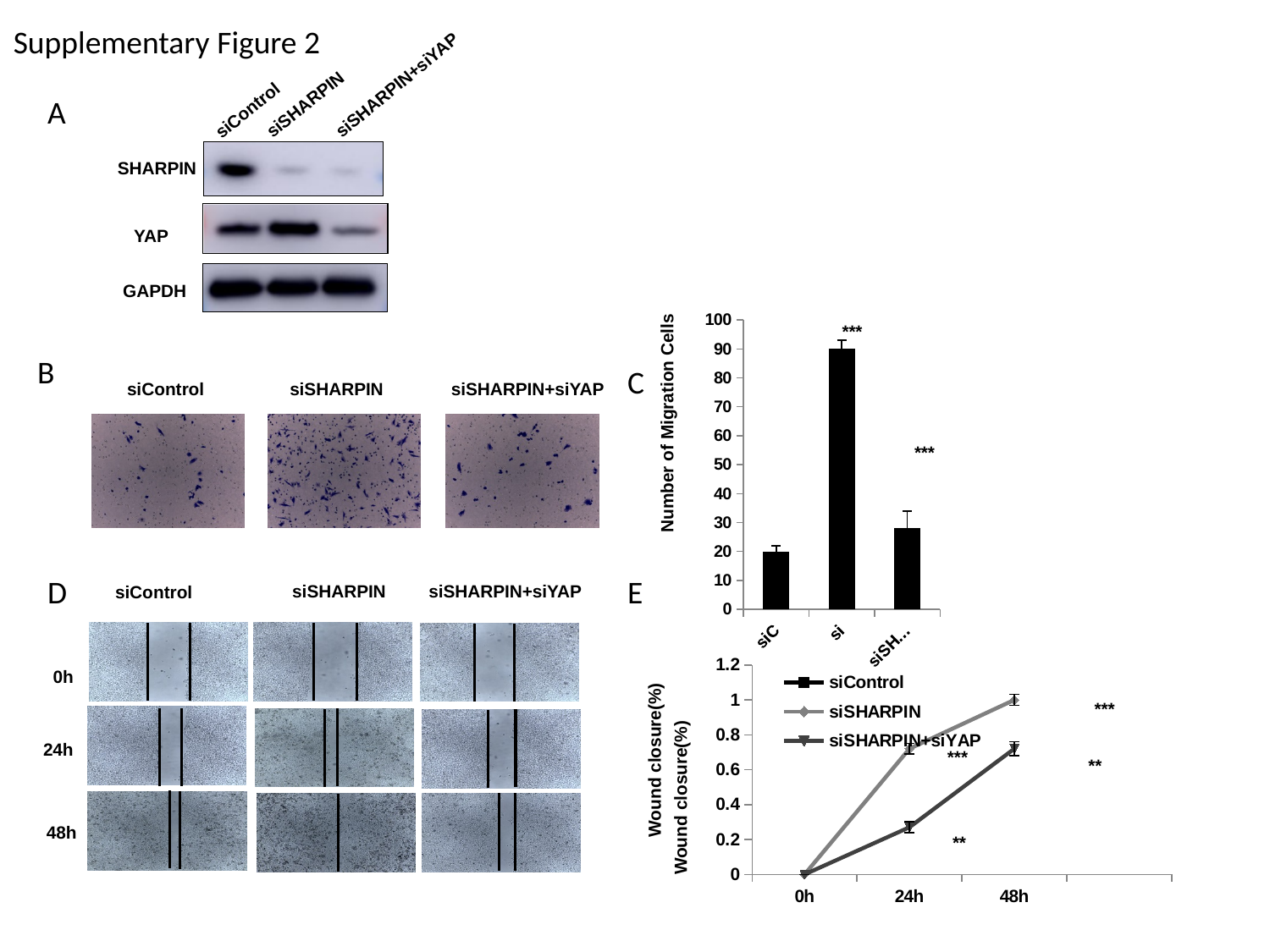
In panel C (Number of Migration Cells), is the value for the third bar (siSH...) greater or less than 40? less In panel C (Number of Migration Cells), is the value for the middle bar (si) greater or less than 80? greater In panel C (Number of Migration Cells), is the value for siC greater or less than 30? less What kind of chart is panel C (Number of Migration Cells)? bar chart In panel E (Wound closure), how many series does the legend list? 3 In panel E (Wound closure), what is the value for siSHARPIN at 48h? 1 In panel C (Number of Migration Cells), which bar is the highest? si (the middle bar) What kind of chart is panel E (Wound closure)? line chart In panel C (Number of Migration Cells), how many bars are plotted? 3 What is the y-axis title of the bar chart in panel C? Number of Migration Cells In panel E (Wound closure), how many time points are shown on the x axis? 3